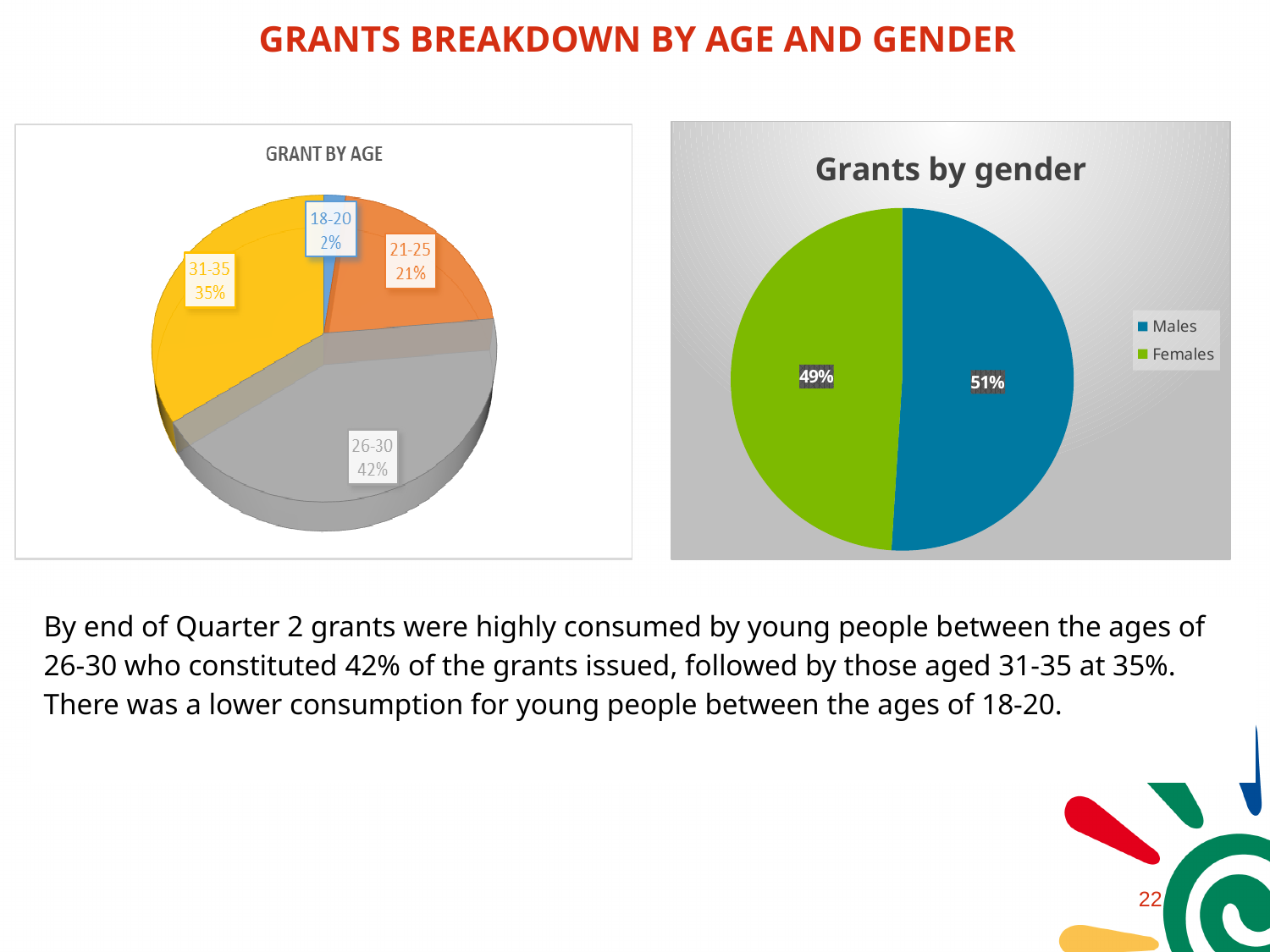
What kind of chart is the 'Grants by gender' chart? Pie chart In the 'GRANT BY AGE' chart, what is the difference in percentage points between the 31-35 and 21-25 age groups? 14 In the 'GRANT BY AGE' chart, how many age groups are shown? 4 In the 'Grants by gender' chart, how many categories does the legend list? 2 In the 'Grants by gender' chart, what share of grants went to females? 49% In the 'Grants by gender' chart, what colour represents Females? Green In the 'GRANT BY AGE' chart, which age group has the smallest share? 18-20 In the 'GRANT BY AGE' chart, what share of grants went to the 26-30 age group? 42% In the 'GRANT BY AGE' chart, which has the larger share, 21-25 or 31-35? 31-35 In the 'GRANT BY AGE' chart, which age group has the largest share? 26-30 In the 'GRANT BY AGE' chart, what share of grants went to the 18-20 age group? 2%